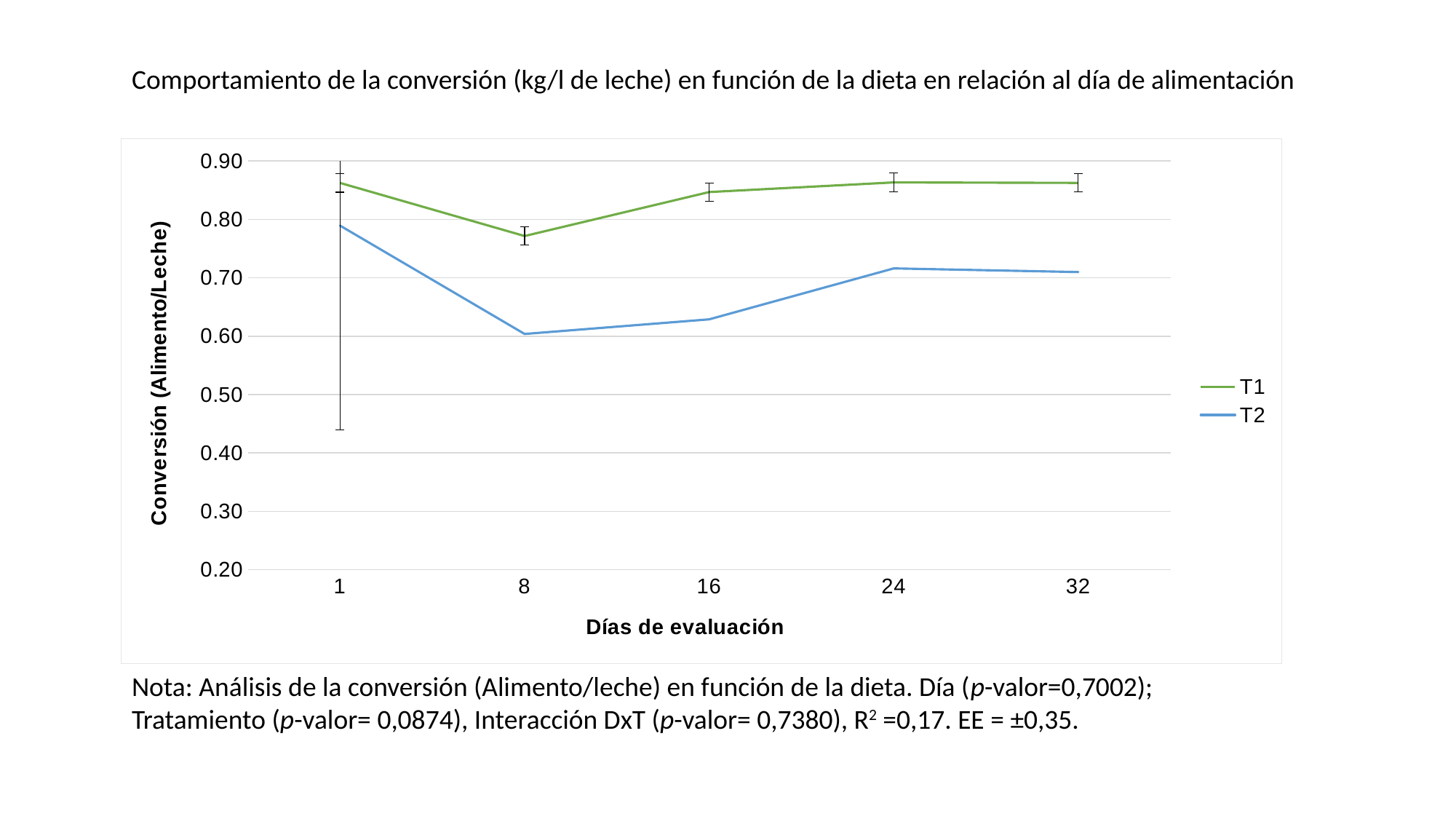
Does the T2 series rise or fall between day 8 and day 24? rise What is the label of the y axis? Conversión (Alimento/Leche) How many evaluation days are plotted along the x axis? 5 On which evaluation day does the T2 series reach its lowest value? 8 On which evaluation day does the T1 series reach its lowest value? 8 What kind of chart is shown on the slide? line chart Is the value for T1 on day 16 greater or less than 0.80? greater Which series has the larger value on day 8, T1 or T2? T1 How many series does the legend list? 2 On which evaluation day does the T2 series reach its highest value? 1 Is the value for T1 on day 8 greater or less than 0.80? less Is the value for T2 on day 8 greater or less than 0.70? less